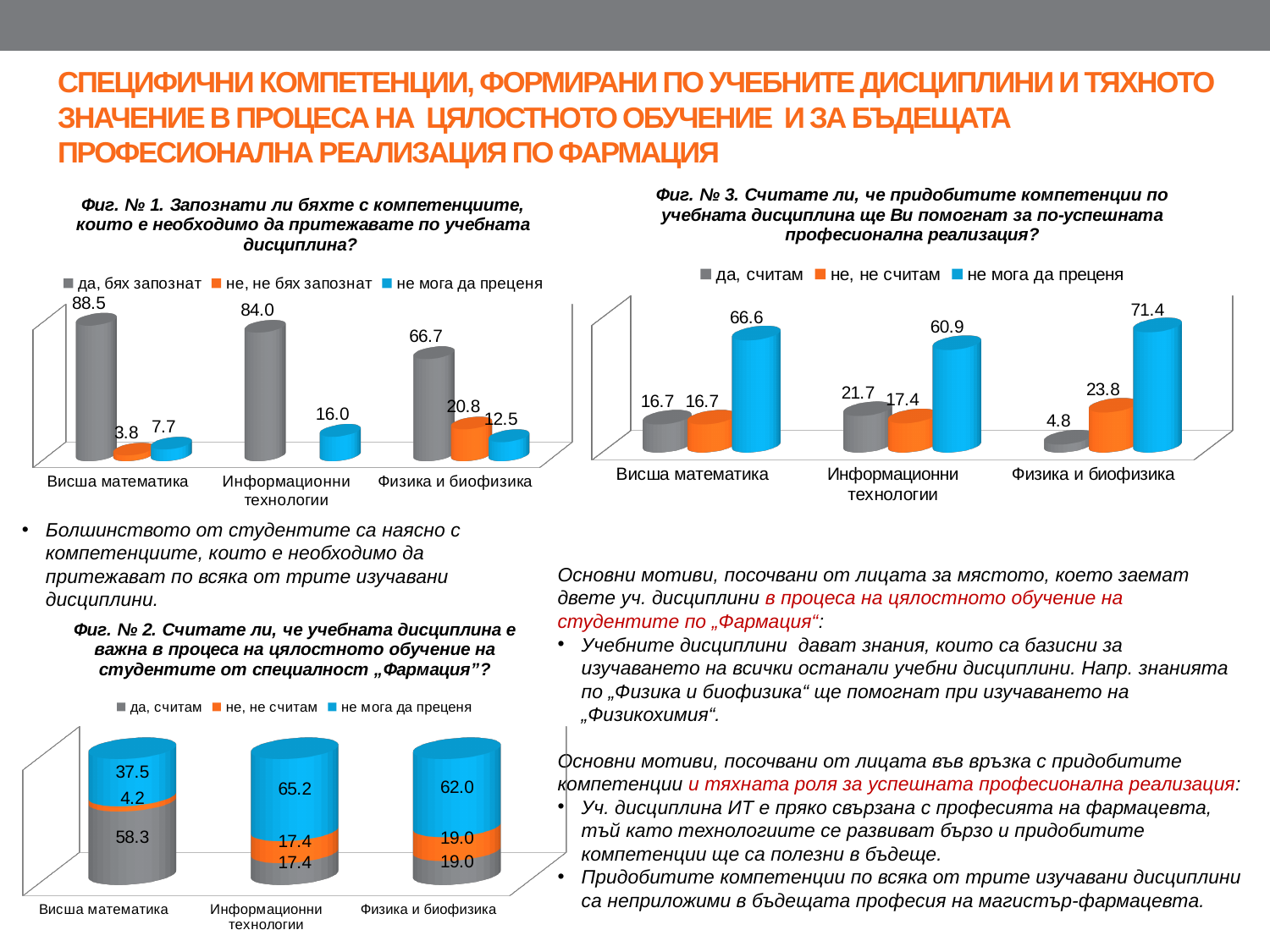
In Фиг. № 3, which is larger for Информационни технологии: "да, считам" or "не, не считам"? да, считам In Фиг. № 2, which discipline has the highest value for "да, считам"? Висша математика In Фиг. № 3, what is the value for "не мога да преценя" for Физика и биофизика? 71.4 In Фиг. № 1, what is the value for "да, бях запознат" for Висша математика? 88.5 In Фиг. № 3, how many disciplines are shown on the x axis? 3 In Фиг. № 2, what is the value for "не мога да преценя" for Информационни технологии? 65.2 In Фиг. № 2, what is the total of the stacked bar for Висша математика? 100.0 In Фиг. № 1, how many series does the legend list? 3 In Фиг. № 1, which discipline has the lowest value for "да, бях запознат"? Физика и биофизика In Фиг. № 3, which discipline has the lowest value for "да, считам"? Физика и биофизика What kind of chart is Фиг. № 2? Stacked bar chart In Фиг. № 1, what is the difference between the "да, бях запознат" values for Висша математика and Информационни технологии? 4.5